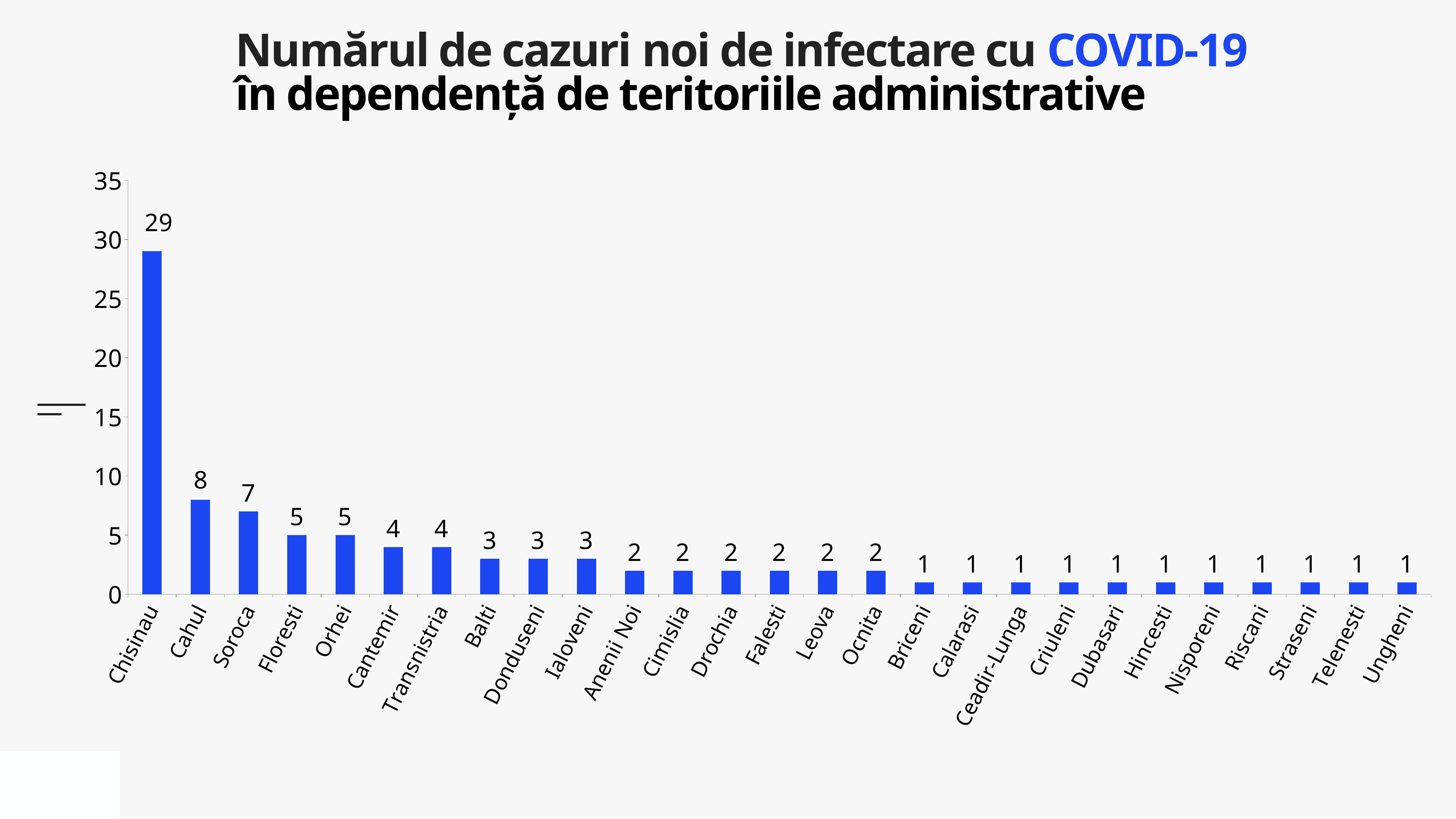
Which has more new COVID-19 cases, Floresti or Ialoveni? Floresti Which administrative territory has the highest number of new COVID-19 cases? Chisinau What is the number of new COVID-19 cases for Transnistria? 4 How many administrative territories are shown on the chart? 27 Is the value for Chisinau greater or less than 25? greater What is the number of new COVID-19 cases for Ungheni? 1 What is the difference between the number of new cases in Soroca and Balti? 4 What is the difference between the number of new cases in Chisinau and Cahul? 21 What kind of chart is shown on the slide? Bar chart What is the number of new COVID-19 cases for Cahul? 8 What is the number of new COVID-19 cases for Soroca? 7 What is the number of new COVID-19 cases for Chisinau? 29